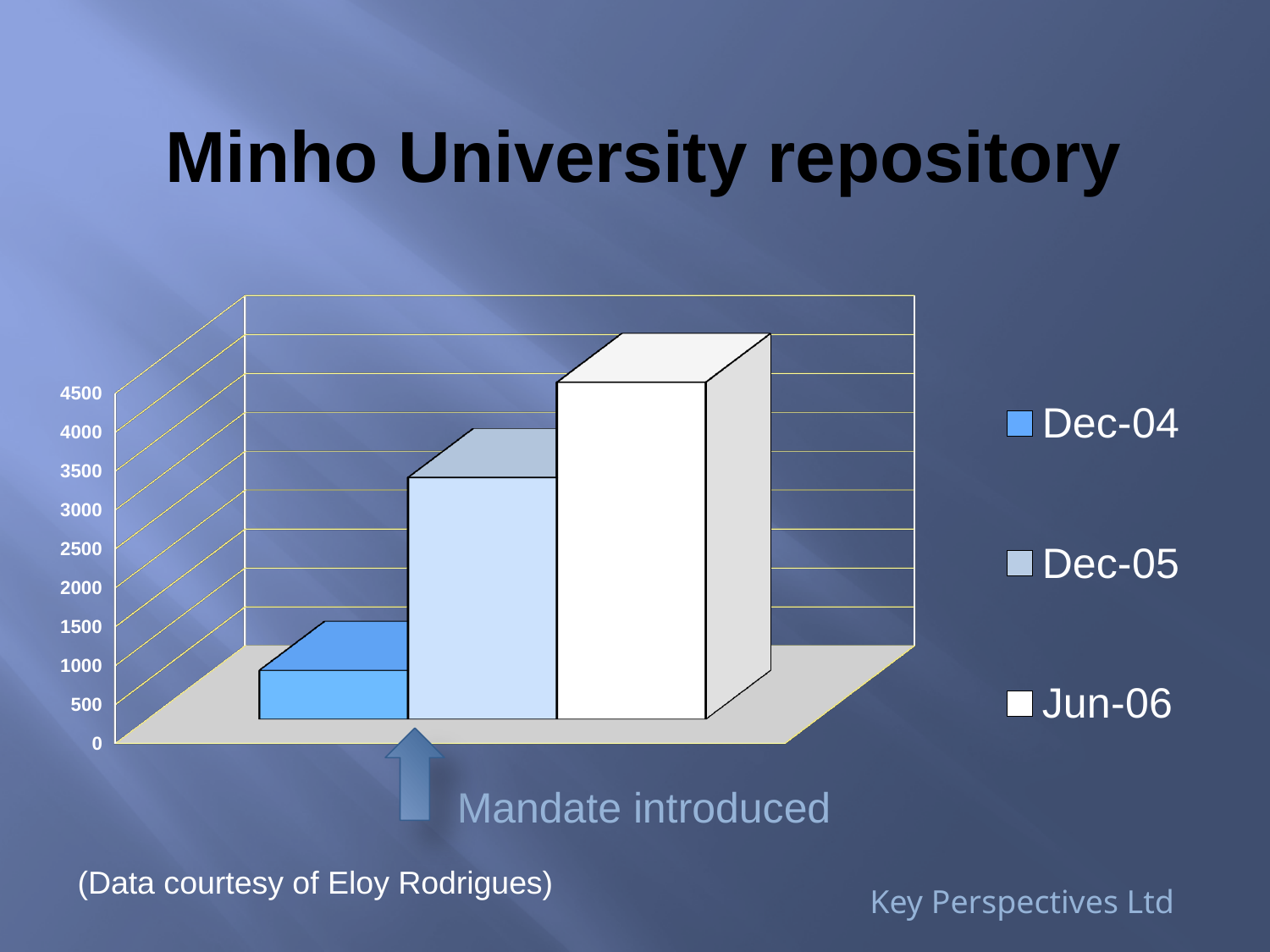
Is the value for Dec-05 greater or less than 2500? greater Which series has the lowest bar? Dec-04 What is the title of the slide containing the chart? Minho University repository How many bars are plotted in the chart? 3 How many series does the legend list? 3 Which is larger, the value for Dec-05 or the value for Dec-04? Dec-05 What event does the arrow annotation below the chart mark? Mandate introduced Which series has the highest bar? Jun-06 Is the value for Dec-04 greater or less than 2000? less Do the bar values rise or fall from Dec-04 to Jun-06? rise What kind of chart is shown on the slide? bar chart Is the value for Jun-06 greater or less than 4000? greater